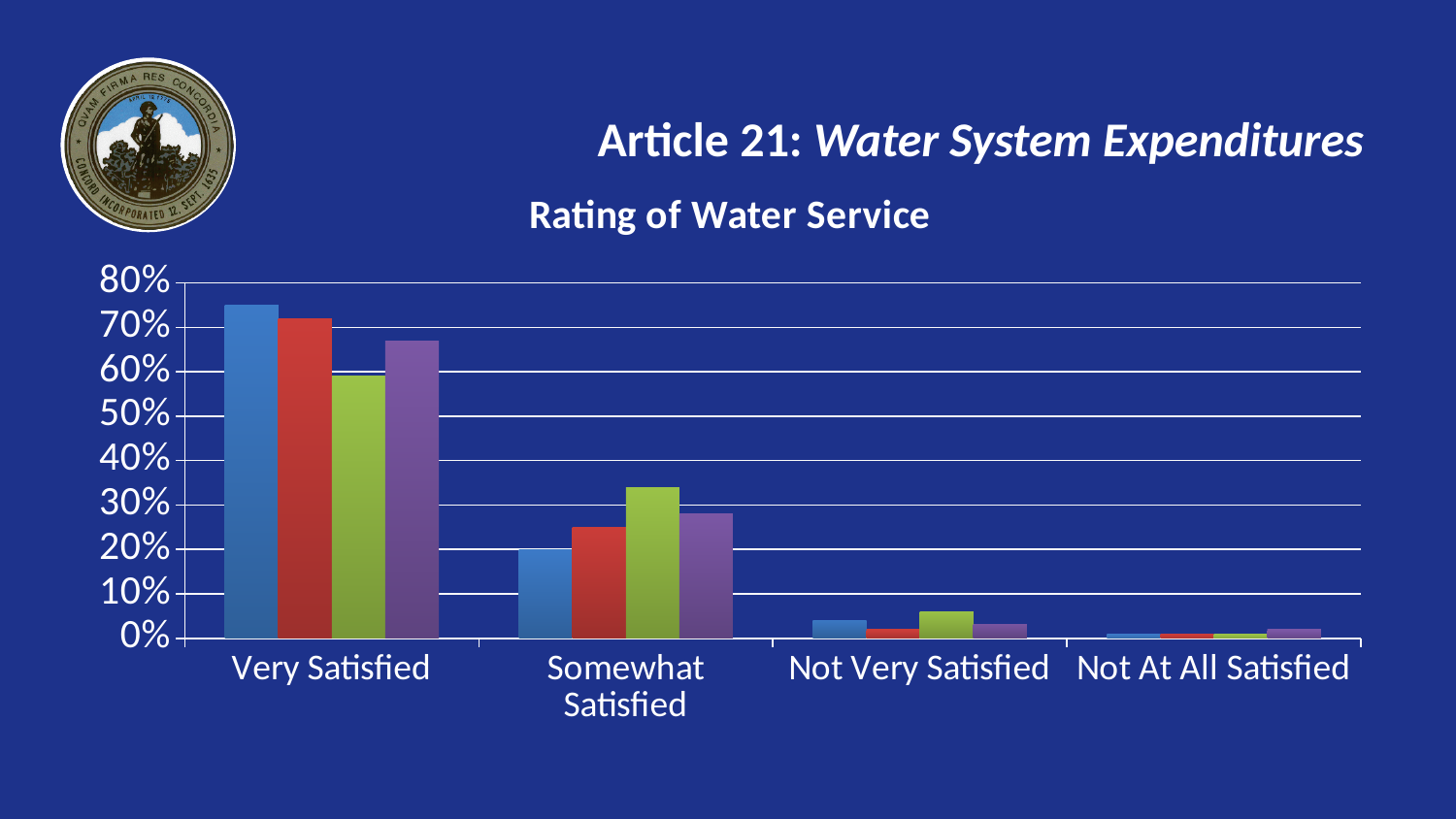
Which category has the tallest bars in the chart? Very Satisfied Are the bars for Very Satisfied greater or less than 50%? greater Which category has the shortest bars in the chart? Not At All Satisfied What kind of chart is shown on the slide? Bar chart Are the bars for Not Very Satisfied greater or less than 10%? less Do the values rise or fall moving from Very Satisfied to Not At All Satisfied along the x axis? fall What is the highest value shown on the y axis of the chart? 80% Are the bars for Somewhat Satisfied greater or less than 40%? less How many bars are plotted for each category in the chart? 4 Which category has larger values, Very Satisfied or Somewhat Satisfied? Very Satisfied How many categories are shown on the x axis of the chart? 4 What is the title of the chart? Rating of Water Service